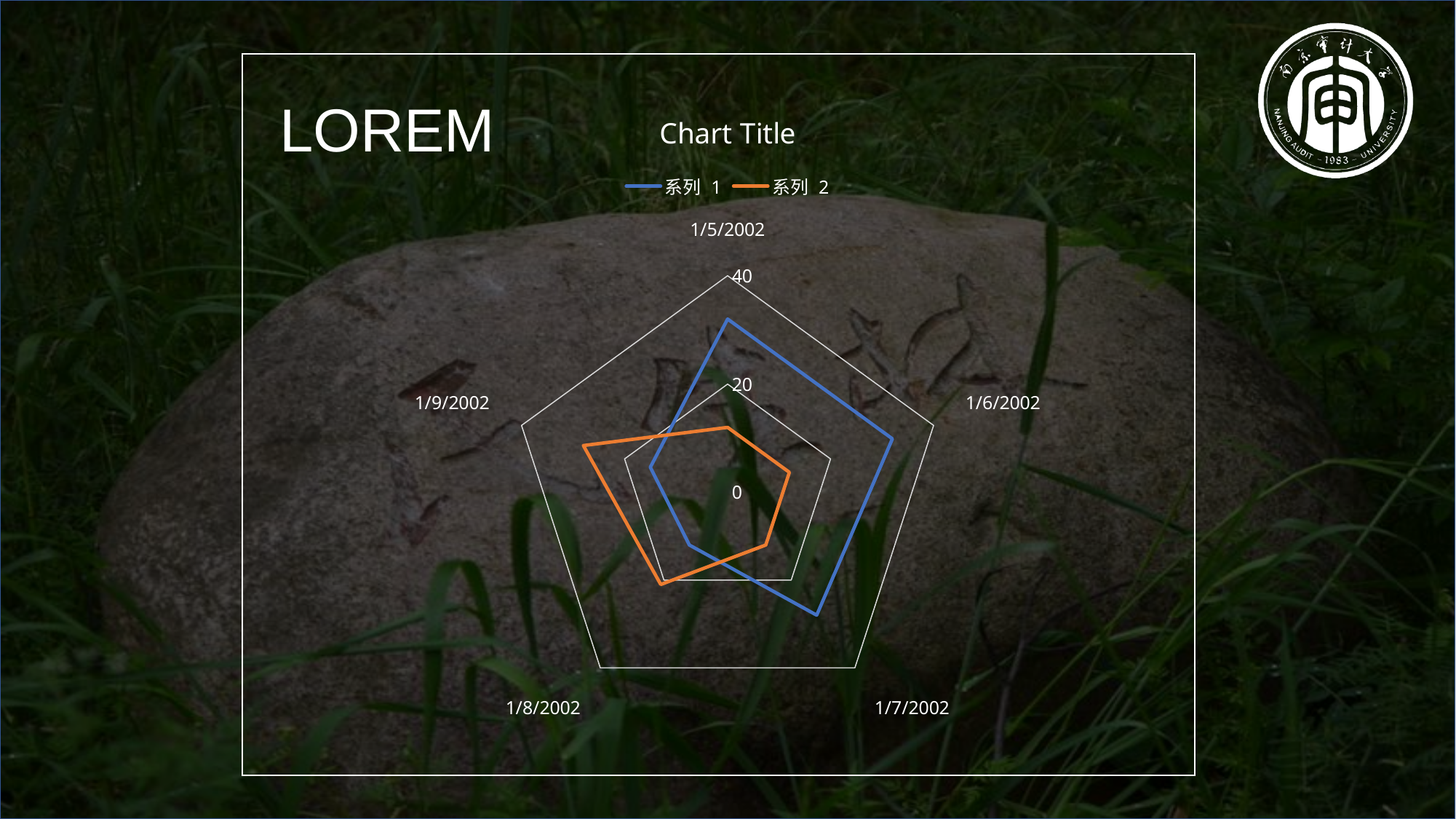
Is the value of 系列 1 for 1/8/2002 greater or less than 20? less For which category does 系列 2 have its highest value? 1/9/2002 For 1/9/2002, which series has the larger value, 系列 1 or 系列 2? 系列 2 How many categories (axes) does the radar chart have? 5 For 1/6/2002, which series has the larger value, 系列 1 or 系列 2? 系列 1 Is the value of 系列 1 for 1/5/2002 greater or less than 20? greater Which series is drawn in orange? 系列 2 What is the title of the chart? Chart Title Is the value of 系列 2 for 1/9/2002 greater or less than 20? greater How many series does the chart's legend list? 2 What kind of chart is shown on the slide? Radar chart